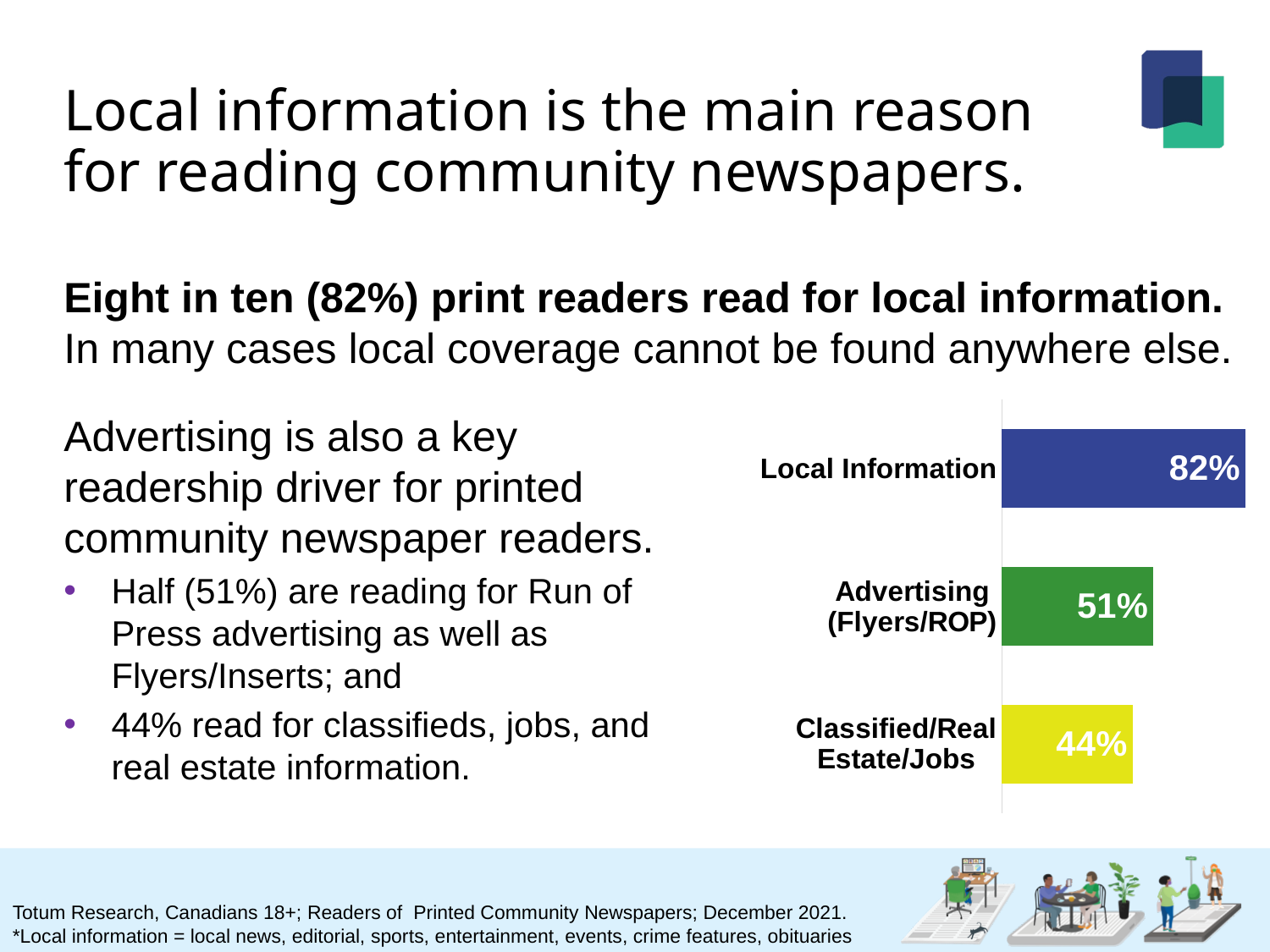
What is the value for Classified/Real Estate/Jobs? 44% Which category has the lowest value? Classified/Real Estate/Jobs What is the difference between the values for Advertising (Flyers/ROP) and Classified/Real Estate/Jobs? 7% What is the difference between the values for Local Information and Advertising (Flyers/ROP)? 31% What is the value for Local Information? 82% How many categories are shown in the chart? 3 Which category has the highest value? Local Information What is the value for Advertising (Flyers/ROP)? 51% What colour is the bar for Classified/Real Estate/Jobs? Yellow What colour is the bar for Local Information? Blue Which is larger, the value for Advertising (Flyers/ROP) or the value for Classified/Real Estate/Jobs? Advertising (Flyers/ROP) What kind of chart is shown on the slide? Bar chart